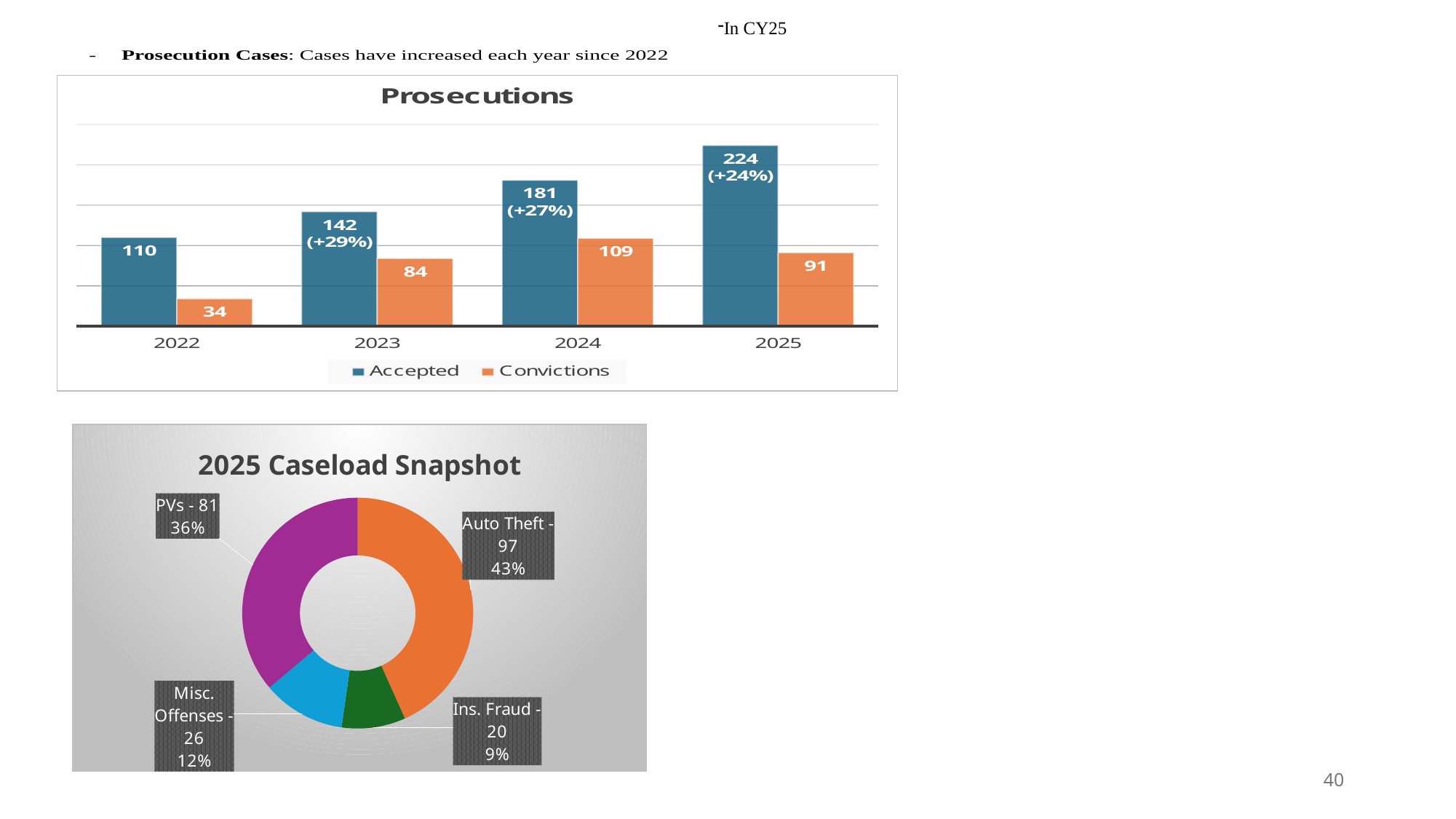
In the Prosecutions chart, what is the Convictions value for 2022? 34 In the Prosecutions chart, do the Accepted values rise or fall from 2022 to 2025? rise What kind of chart is the Prosecutions chart? bar chart In the Prosecutions chart, which year has the highest Accepted value? 2025 In the Prosecutions chart, what is the Accepted value for 2024? 181 In the Prosecutions chart, which year has the lowest Convictions value? 2022 In the 2025 Caseload Snapshot chart, what is the value for Misc. Offenses? 26 In the 2025 Caseload Snapshot chart, what share does Auto Theft have? 43% In the Prosecutions chart, which is larger: Convictions in 2024 or Convictions in 2025? Convictions in 2024 In the Prosecutions chart, what is the difference between Accepted and Convictions in 2025? 133 In the 2025 Caseload Snapshot chart, how many categories are shown? 4 In the Prosecutions chart, how many series does the legend list? 2